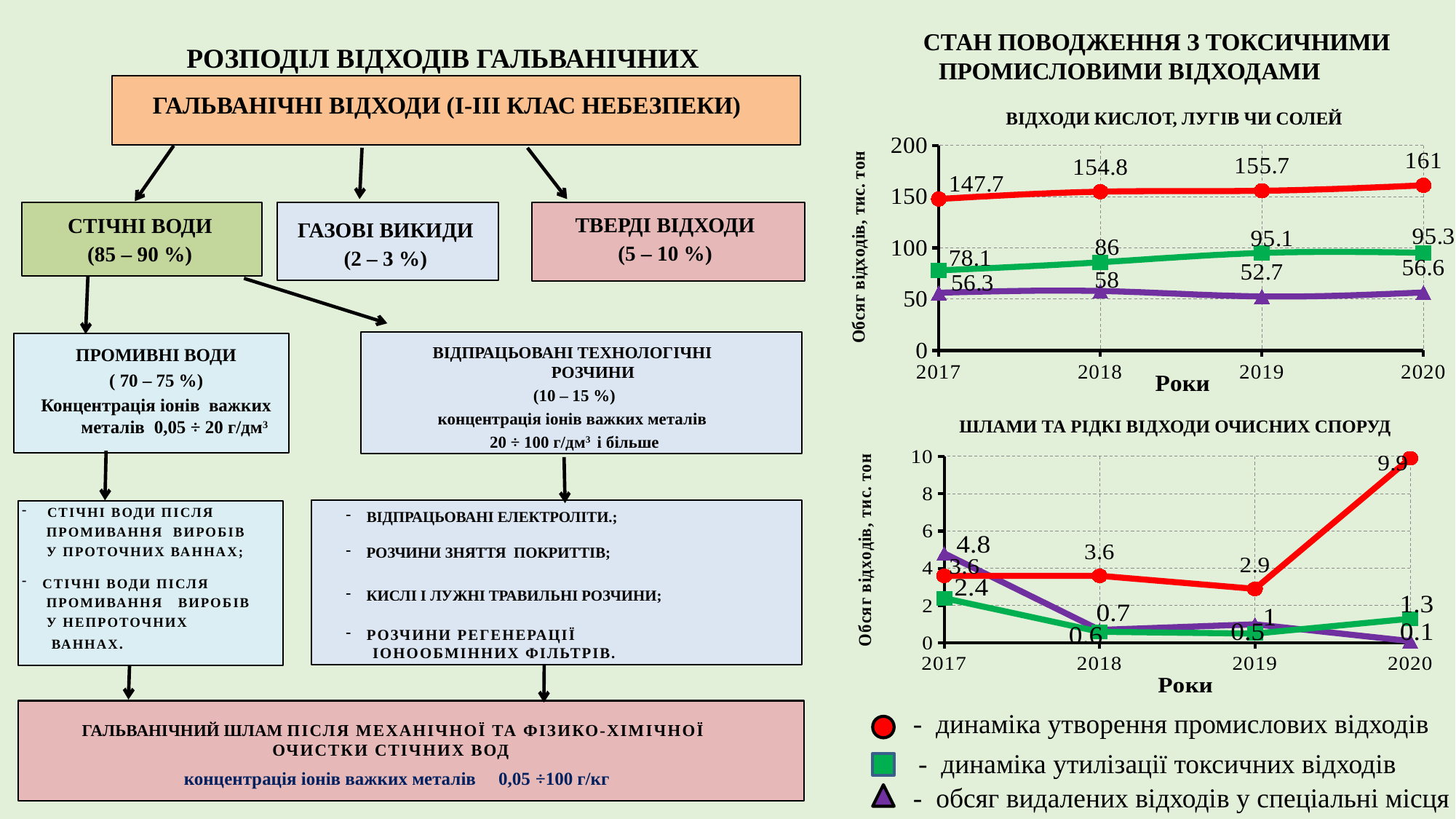
In the chart 'ШЛАМИ ТА РІДКІ ВІДХОДИ ОЧИСНИХ СПОРУД', which is larger in 2017: the purple series or the green series? purple series In the chart 'ВІДХОДИ КИСЛОТ, ЛУГІВ ЧИ СОЛЕЙ', what is the difference between the red series and the green series in 2020? 65.7 In the chart 'ШЛАМИ ТА РІДКІ ВІДХОДИ ОЧИСНИХ СПОРУД', what is the value of the purple series in 2017? 4.8 In the chart 'ВІДХОДИ КИСЛОТ, ЛУГІВ ЧИ СОЛЕЙ', in which year is the purple series (обсяг видалених відходів у спеціальні місця) lowest? 2019 In the chart 'ШЛАМИ ТА РІДКІ ВІДХОДИ ОЧИСНИХ СПОРУД', in which year is the red series highest? 2020 In the chart 'ВІДХОДИ КИСЛОТ, ЛУГІВ ЧИ СОЛЕЙ', does the red series rise or fall from 2017 to 2020? rise In the chart 'ШЛАМИ ТА РІДКІ ВІДХОДИ ОЧИСНИХ СПОРУД', what is the value of the red series in 2020? 9.9 In the chart 'ВІДХОДИ КИСЛОТ, ЛУГІВ ЧИ СОЛЕЙ', what is the value of the red series (динаміка утворення промислових відходів) in 2020? 161 In the chart 'ВІДХОДИ КИСЛОТ, ЛУГІВ ЧИ СОЛЕЙ', what is the value of the green series (динаміка утилізації токсичних відходів) in 2017? 78.1 What type of chart is 'ШЛАМИ ТА РІДКІ ВІДХОДИ ОЧИСНИХ СПОРУД'? line chart In the chart 'ШЛАМИ ТА РІДКІ ВІДХОДИ ОЧИСНИХ СПОРУД', what is the difference between the red series values in 2020 and 2019? 7 How many years are shown on the x axis of the chart 'ВІДХОДИ КИСЛОТ, ЛУГІВ ЧИ СОЛЕЙ'? 4